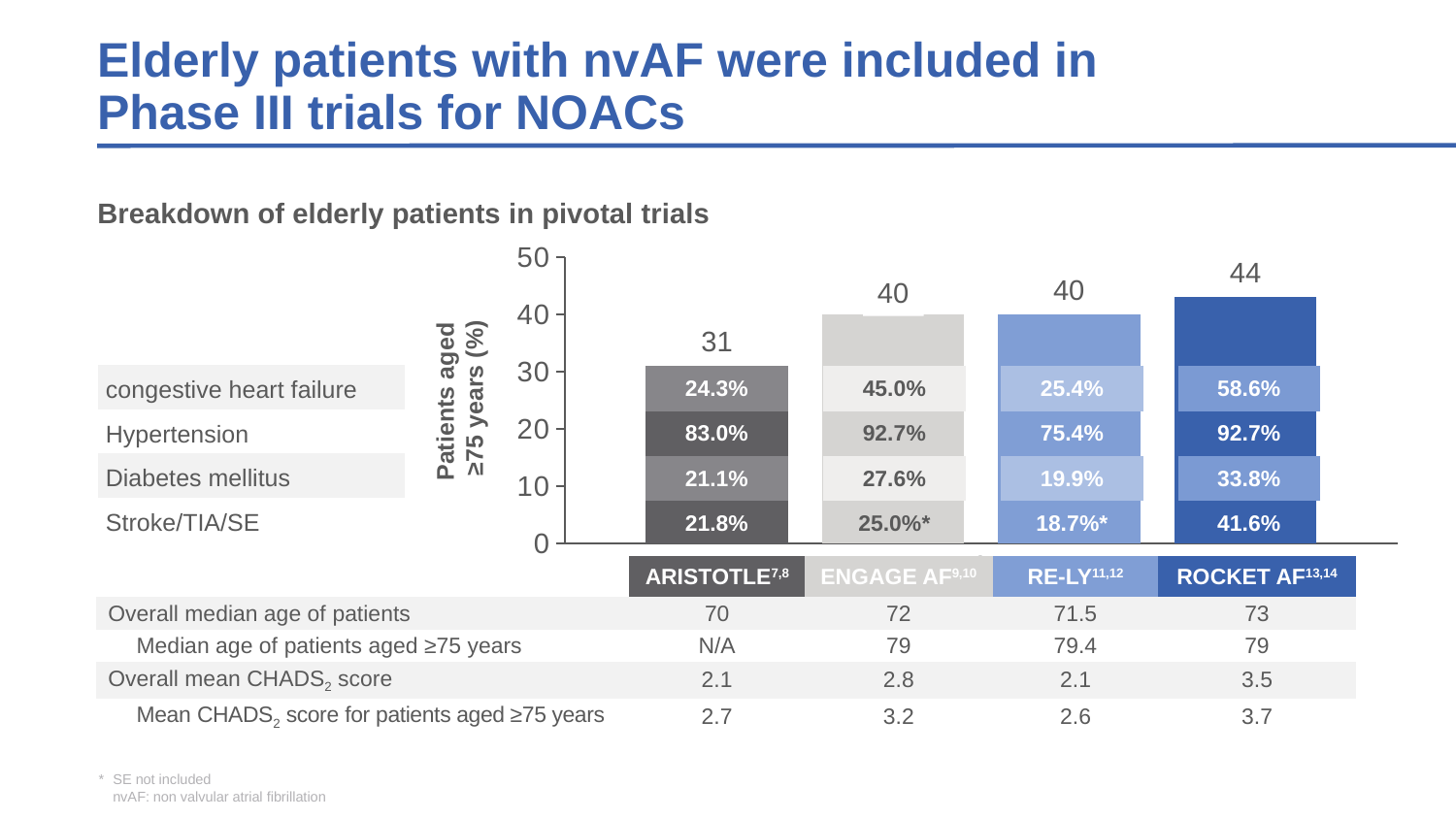
What kind of chart is used to show the breakdown of elderly patients in pivotal trials? bar chart What value is shown above the RE-LY bar? 40 What percentage of patients aged ≥75 years is shown for the ROCKET AF trial? 44 What is the label of the y axis of the chart? Patients aged ≥75 years (%) Which trial has the highest percentage of patients aged ≥75 years? ROCKET AF Which has a larger percentage of patients aged ≥75 years, ENGAGE AF or ARISTOTLE? ENGAGE AF Which trial has the lowest percentage of patients aged ≥75 years? ARISTOTLE Is the value for ARISTOTLE greater or less than 40? less How many trials are shown as bars in the chart? 4 What percentage for hypertension is printed inside the ENGAGE AF bar? 92.7% What is the difference between the ROCKET AF and ARISTOTLE values for patients aged ≥75 years? 13 What percentage of patients aged ≥75 years is shown for the ARISTOTLE trial? 31